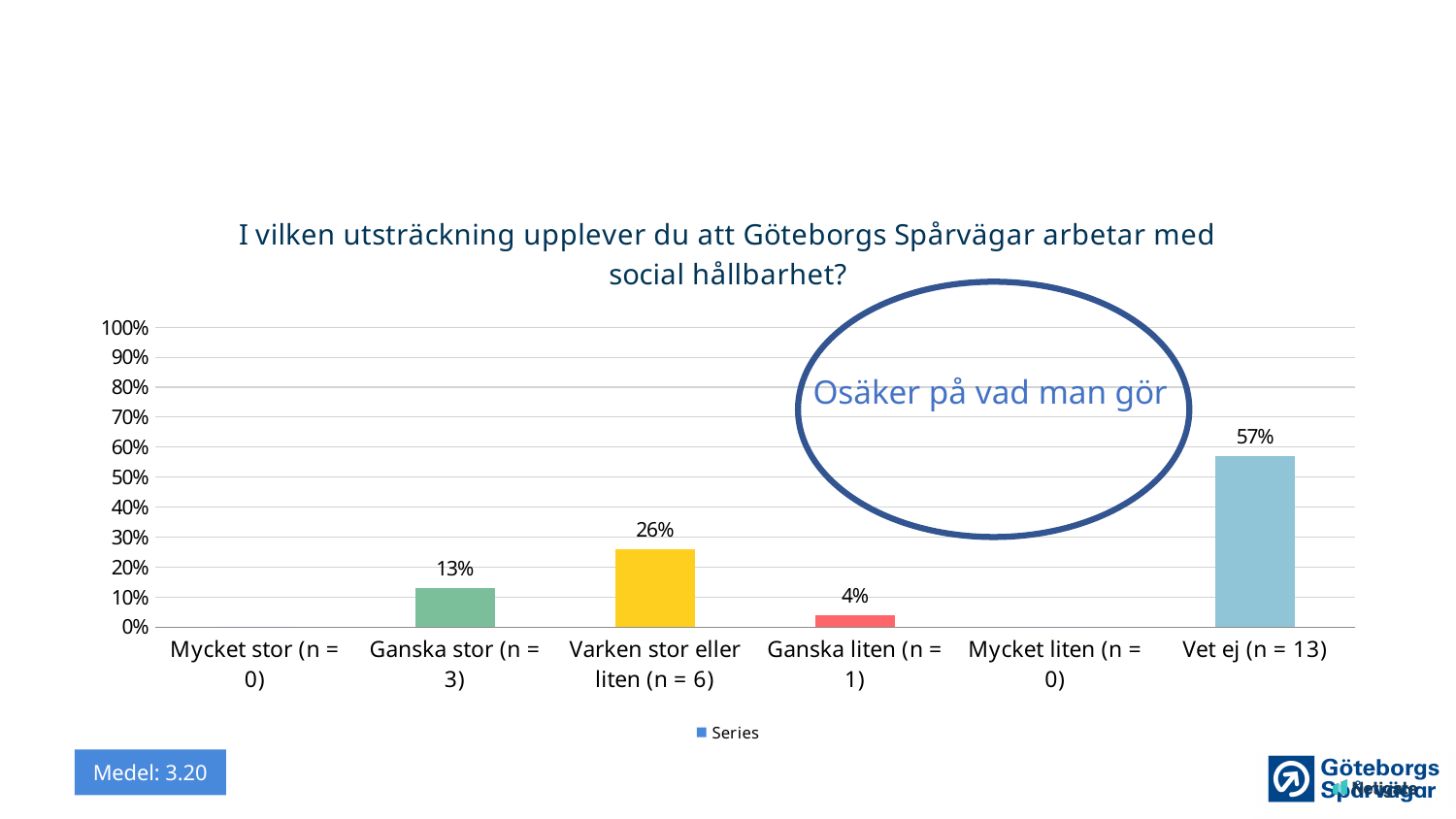
Which category has the highest value? Vet ej (n = 13) What is the value for "Ganska stor (n = 3)"? 13% What is the difference between the values for "Vet ej (n = 13)" and "Varken stor eller liten (n = 6)"? 31 percentage points What kind of chart is shown on the slide? bar chart What is the value for "Ganska liten (n = 1)"? 4% What is the value for "Vet ej (n = 13)"? 57% Is the value for "Vet ej (n = 13)" greater or less than 50%? greater What is the difference between the values for "Ganska stor (n = 3)" and "Ganska liten (n = 1)"? 9 percentage points What is the value for "Varken stor eller liten (n = 6)"? 26% Which is larger, the value for "Ganska stor (n = 3)" or the value for "Varken stor eller liten (n = 6)"? Varken stor eller liten (n = 6) What is the title of the chart? I vilken utsträckning upplever du att Göteborgs Spårvägar arbetar med social hållbarhet? How many categories are shown on the x axis? 6